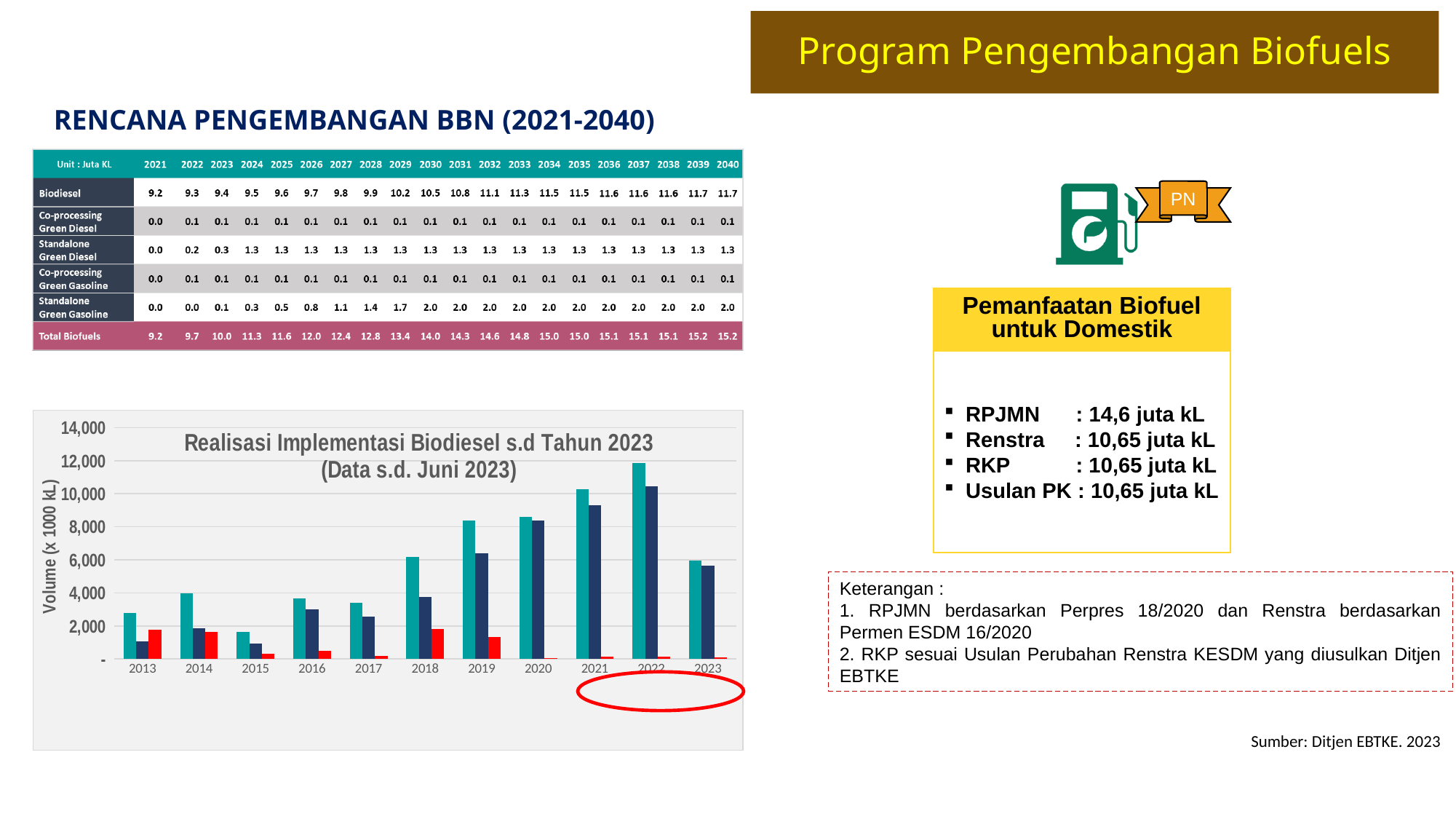
Is the teal bar for 2023 greater or less than 4,000? greater Is the teal bar for 2015 greater or less than 2,000? less How many years are shown on the x axis of the bar chart? 11 In which year is the teal bar the tallest in the bar chart? 2022 Is the teal bar for 2022 greater or less than 10,000? greater What is the title of the bar chart? Realisasi Implementasi Biodiesel s.d Tahun 2023 (Data s.d. Juni 2023) What kind of chart is shown on the slide? bar chart In which year is the teal bar the shortest in the bar chart? 2015 Which is larger in the bar chart: the dark navy bar for 2018 or the dark navy bar for 2019? 2019 Which is larger in the bar chart: the teal bar for 2021 or the teal bar for 2022? 2022 What is the label of the vertical axis of the bar chart? Volume (x 1000 kL)